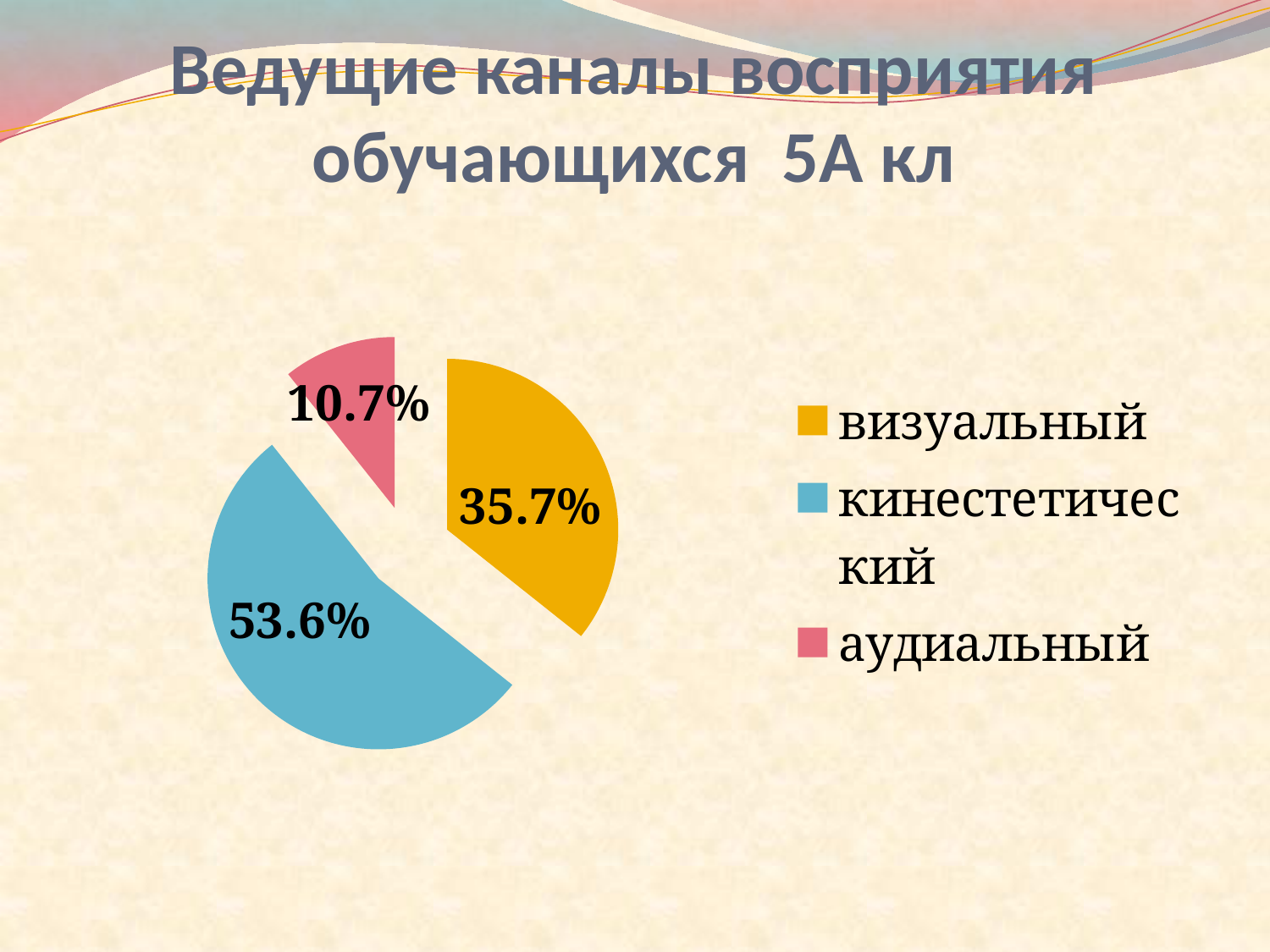
What kind of chart is shown on the slide? pie chart What share of the pie does визуальный have? 35.7% What is the difference between the shares of кинестетический and визуальный? 17.9% Which category has the smallest slice of the pie? аудиальный What is the title of the slide? Ведущие каналы восприятия обучающихся 5А кл What share of the pie does кинестетический have? 53.6% Which category has the largest slice of the pie? кинестетический What colour is the slice for кинестетический? blue Which is larger, the share of визуальный or the share of аудиальный? визуальный What is the difference between the shares of визуальный and аудиальный? 25.0% How many categories does the pie chart have? 3 What share of the pie does аудиальный have? 10.7%